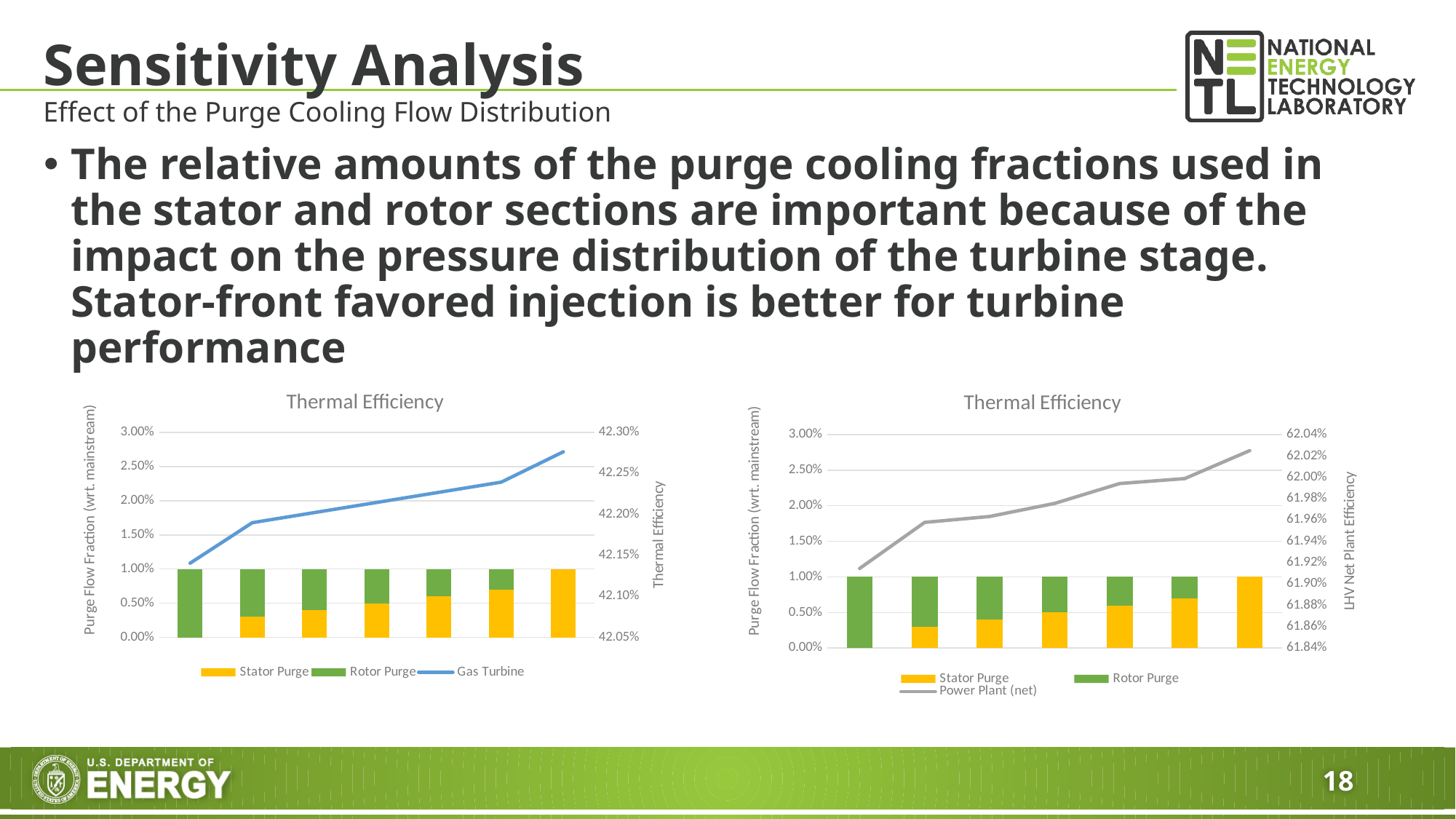
What is the label of the right-hand vertical axis of the right chart? LHV Net Plant Efficiency In the left chart, is the Gas Turbine value at the last (rightmost) point greater or less than 42.25%? greater In the right chart, how many series does the legend list? 3 In the left chart, how many stacked bars are plotted? 7 What kind of chart is the left chart? Combined stacked bar and line chart In the right chart, is the Stator Purge portion of the second bar greater or less than 0.50%? less In the right chart, how many stacked bars are plotted? 7 In the left chart, how many series does the legend list? 3 In the left chart, does the Gas Turbine line rise or fall from left to right? Rises In the right chart, is the Power Plant (net) value at the first (leftmost) point greater or less than 61.96%? less What is the title of the left chart? Thermal Efficiency In the right chart, does the Power Plant (net) line rise or fall from left to right? Rises